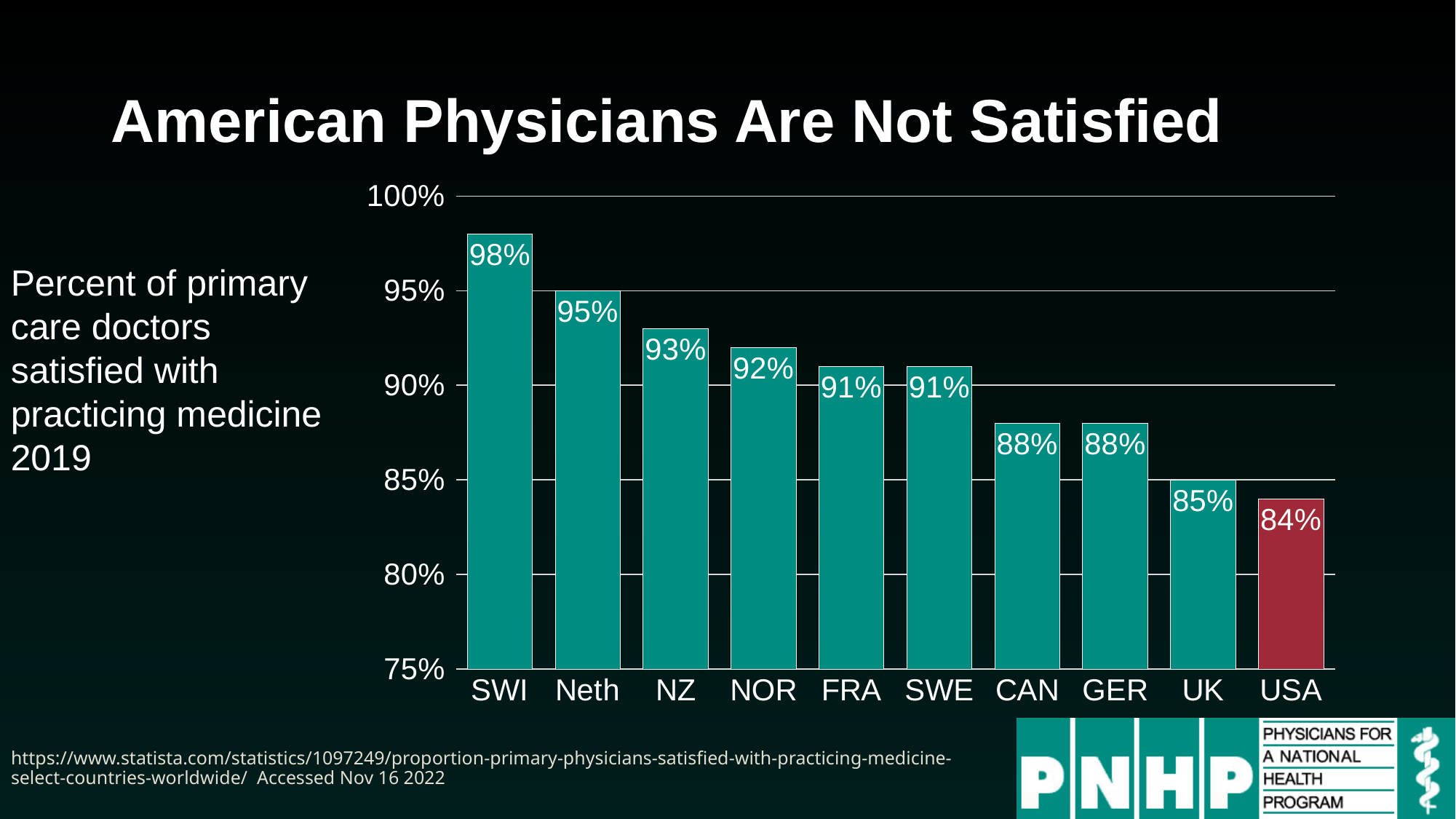
Which country has the highest value? SWI What is the difference between the values for SWI and USA? 14% What is the value for SWI? 98% Which country has the lowest value? USA What is the value for NOR? 92% How many countries are shown on the chart? 10 Which bar is coloured differently from the others? USA What kind of chart is shown on the slide? bar chart What is the value for USA? 84% Which is larger, the value for NZ or the value for CAN? NZ What is the difference between the values for Neth and UK? 10% Is the value for GER greater or less than 90%? less